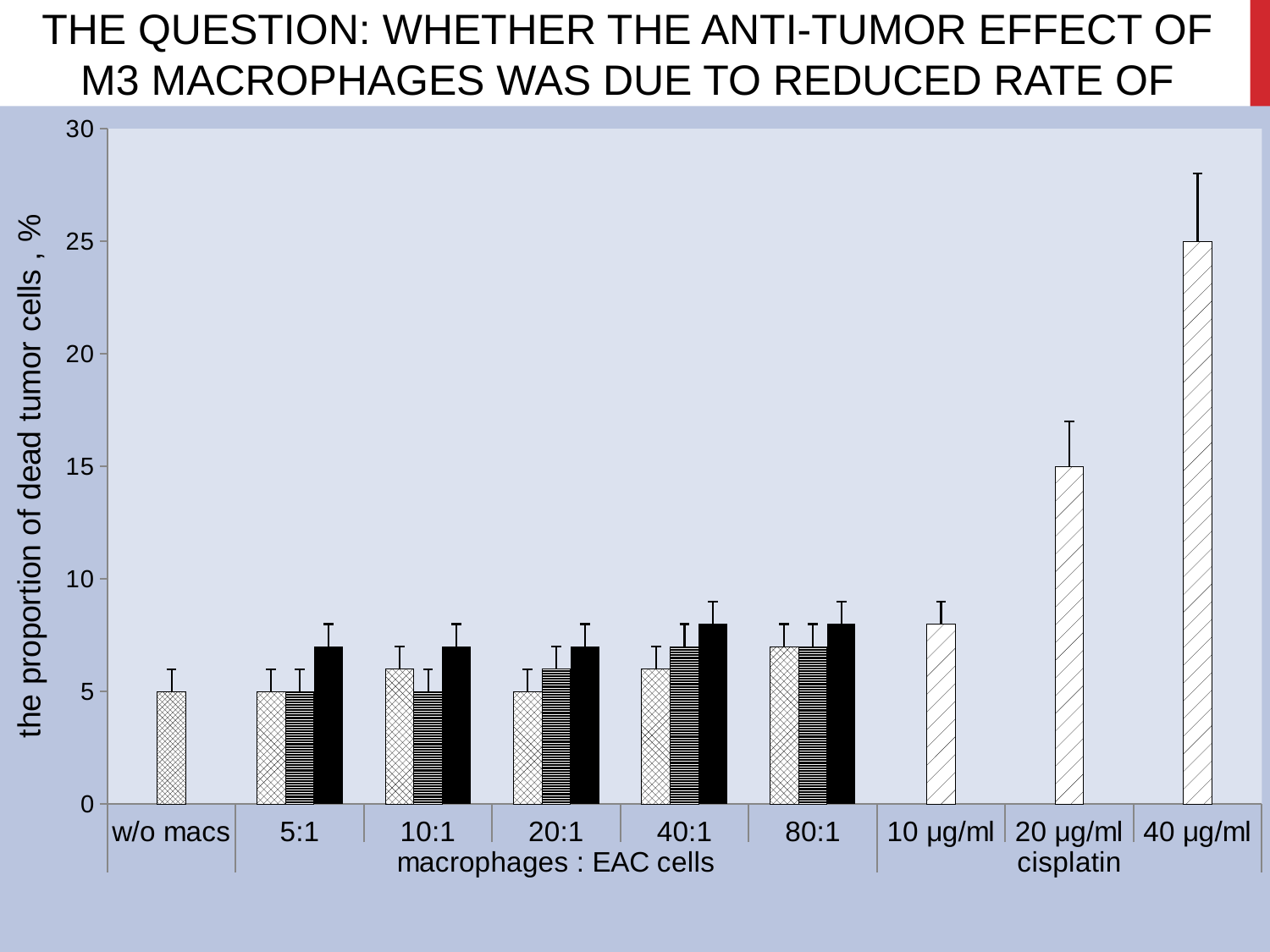
What is the difference between the value for 40 µg/ml cisplatin and the value for 'w/o macs'? 20 What is the label of the y axis? the proportion of dead tumor cells , % What is the proportion of dead tumor cells for 20 µg/ml cisplatin? 15 Which is larger, the value for 20 µg/ml cisplatin or the value for 10 µg/ml cisplatin? 20 µg/ml cisplatin Do the cisplatin bars rise or fall as the concentration increases from 10 µg/ml to 40 µg/ml? rise What is the proportion of dead tumor cells for 40 µg/ml cisplatin? 25 How many categories are labelled along the x axis? 9 What is the proportion of dead tumor cells for the 'w/o macs' category? 5 Is the value for 10 µg/ml cisplatin greater or less than 10? less Which category has the highest bar on the chart? 40 µg/ml cisplatin What kind of chart is shown on the slide? bar chart What is the difference between the values for 40 µg/ml and 20 µg/ml cisplatin? 10